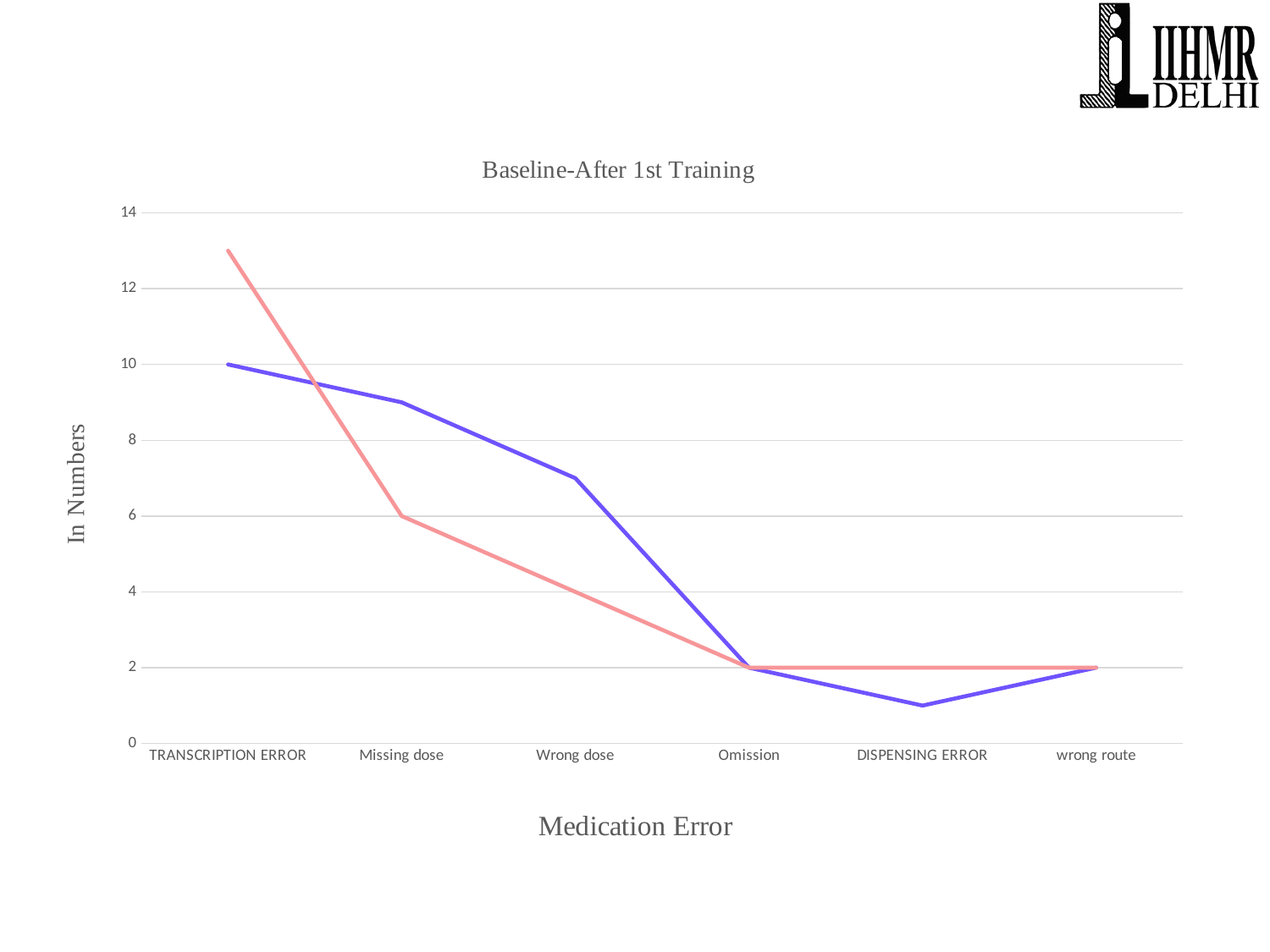
Is the value of the pink line for TRANSCRIPTION ERROR greater or less than 12? greater How many medication error categories are shown on the x axis? 6 What is the title of the chart? Baseline-After 1st Training What is the value of the pink line for Wrong dose? 4 Is the value of the blue line for DISPENSING ERROR greater or less than 2? less For Wrong dose, which line has the larger value, the blue line or the pink line? blue line What type of chart is shown on the slide? line chart What is the value of the pink line for Missing dose? 6 What is the value of the blue line for TRANSCRIPTION ERROR? 10 What is the label of the y axis? In Numbers Which category has the highest value on the blue line? TRANSCRIPTION ERROR What is the value of the pink line for Omission? 2